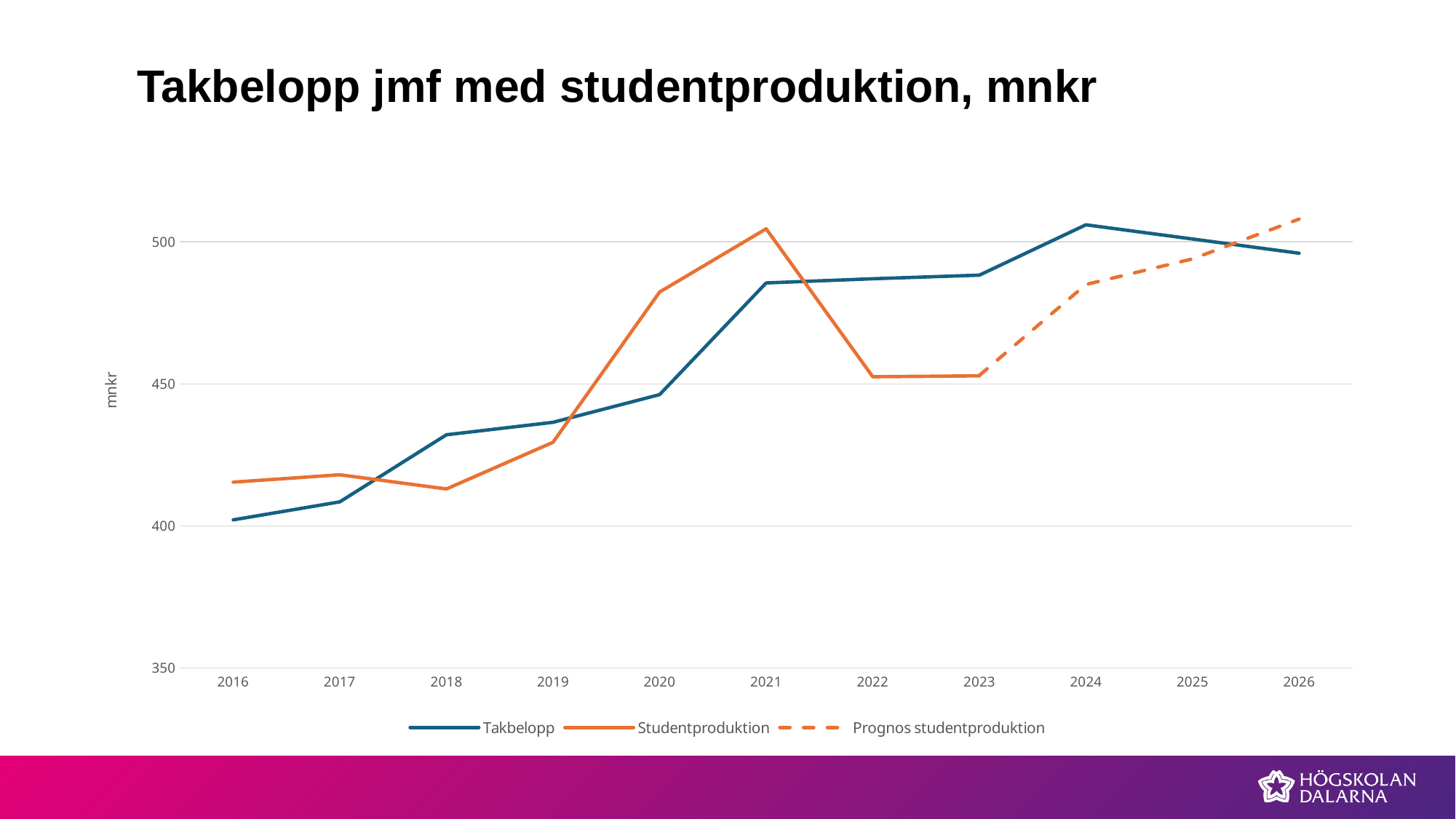
In which year does the Takbelopp line reach its highest value? 2024 What is the label on the y axis? mnkr In which year does the solid Studentproduktion line reach its highest value? 2021 Is the Takbelopp value for 2020 greater or less than 450? less In 2022, which is larger: Takbelopp or Studentproduktion? Takbelopp How many series does the legend list? 3 How many years are shown on the x axis? 11 What kind of chart is shown on the slide? line chart Is the Studentproduktion value for 2021 greater or less than 500? greater Does the Takbelopp line rise or fall from 2016 to 2024? rise In which year is the Takbelopp value lowest? 2016 Is the Prognos studentproduktion value for 2026 greater or less than 500? greater